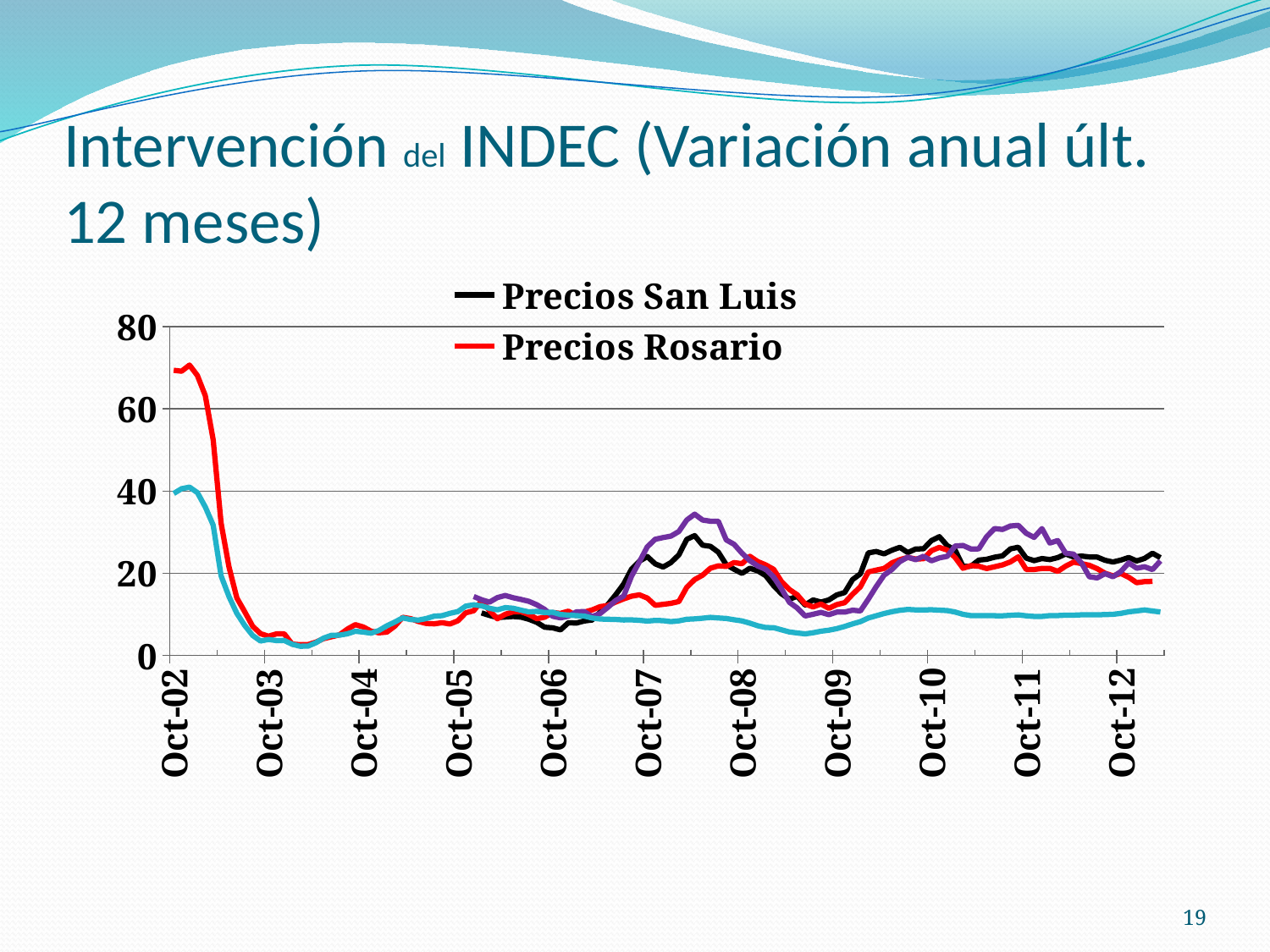
Is the value for Precios Rosario at Oct-02 greater or less than 60? greater What are the two series named in the chart legend? Precios San Luis and Precios Rosario How many series does the chart legend list? 2 Does the Precios Rosario line rise or fall between Oct-02 and Oct-03? fall Is the value for Precios Rosario at Oct-03 greater or less than 20? less At Oct-07, which is higher: Precios San Luis or Precios Rosario? Precios San Luis Is the value for Precios San Luis at Oct-10 greater or less than 20? greater What colour is the Precios Rosario line? red What kind of chart is shown on the slide? line chart How many labelled tick marks are on the x axis? 11 Which of the two legend series reaches the highest value anywhere on the chart? Precios Rosario